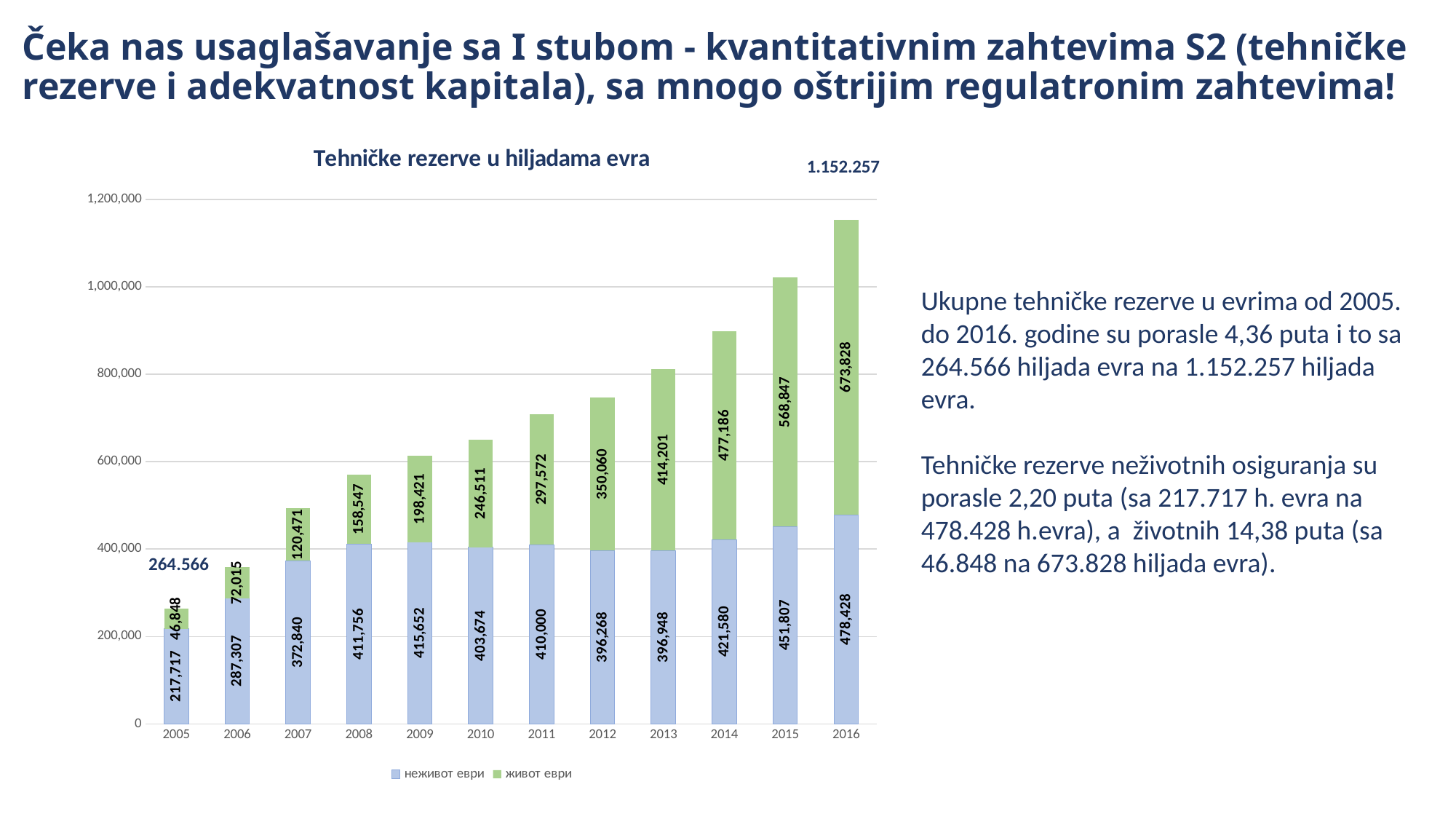
How many series does the legend list? 2 Which is larger in 2013, живот еври or неживот еври? живот еври In which year is the живот еври value highest? 2016 How many years are shown on the x axis? 12 What is the value of живот еври for 2013? 414,201 What is the value of неживот еври for 2009? 415,652 Does the живот еври value rise or fall from 2005 to 2016? Rise What is the difference between живот еври and неживот еври in 2016? 195,400 What kind of chart is shown on the slide? Stacked bar chart In which year is the неживот еври value lowest? 2005 What total is annotated above the 2016 bar? 1.152.257 What is the total of the stacked bar for 2010? 650,185